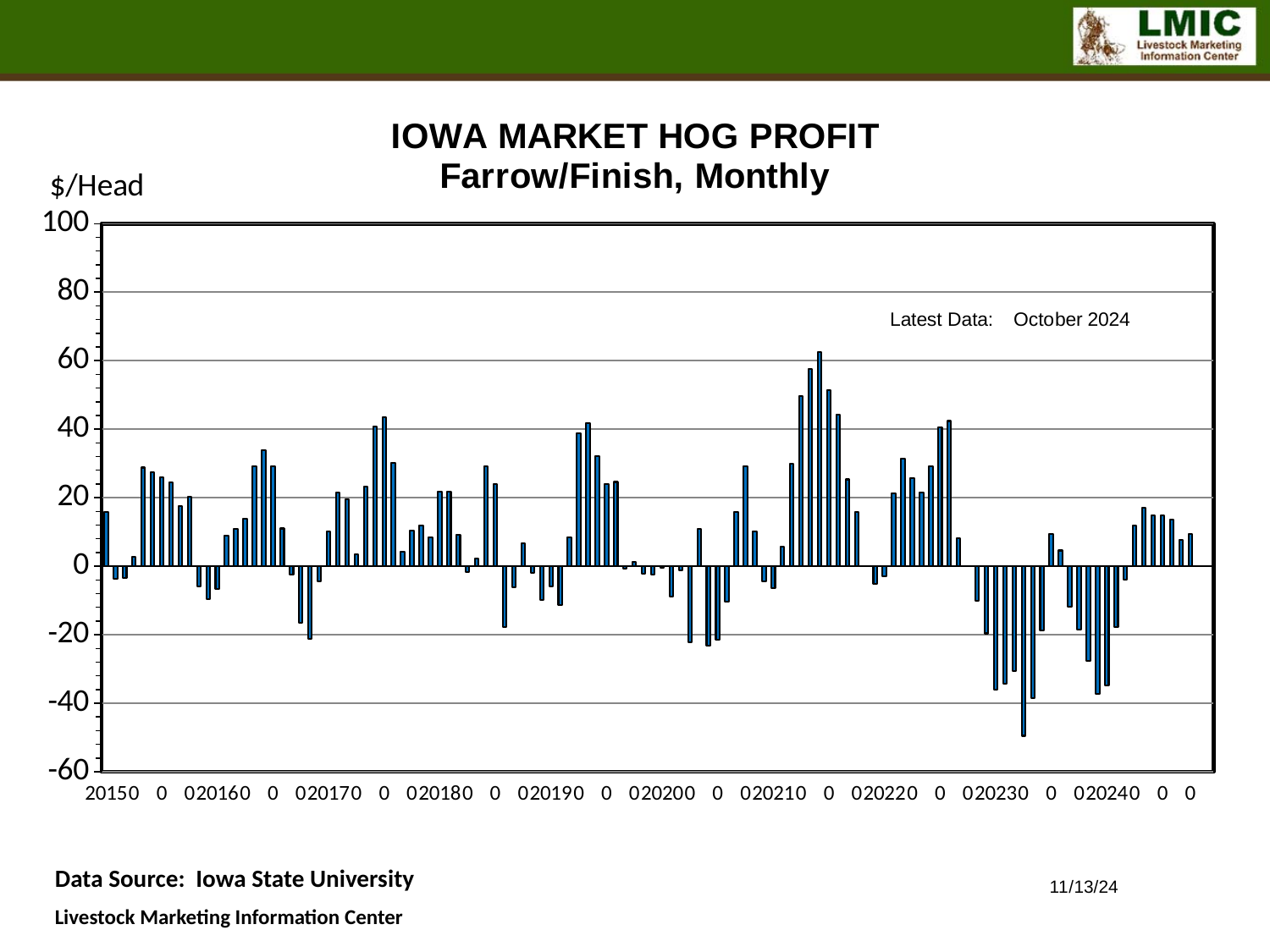
In which year does the chart reach its highest monthly profit? 2021 Is the highest value in 2023 greater or less than 20? less Is the highest value on the chart greater or less than 40? greater Which is larger, the peak monthly profit in 2021 or the peak monthly profit in 2017? 2021 According to the note on the chart, what is the latest data month? October 2024 What is the title of the chart? IOWA MARKET HOG PROFIT Farrow/Finish, Monthly What kind of chart is shown on the slide? bar chart Do the values generally rise or fall from 2023 to 2024? rise In which year does the chart reach its lowest monthly profit? 2023 Is the value for the last bar (October 2024) greater or less than 20? less